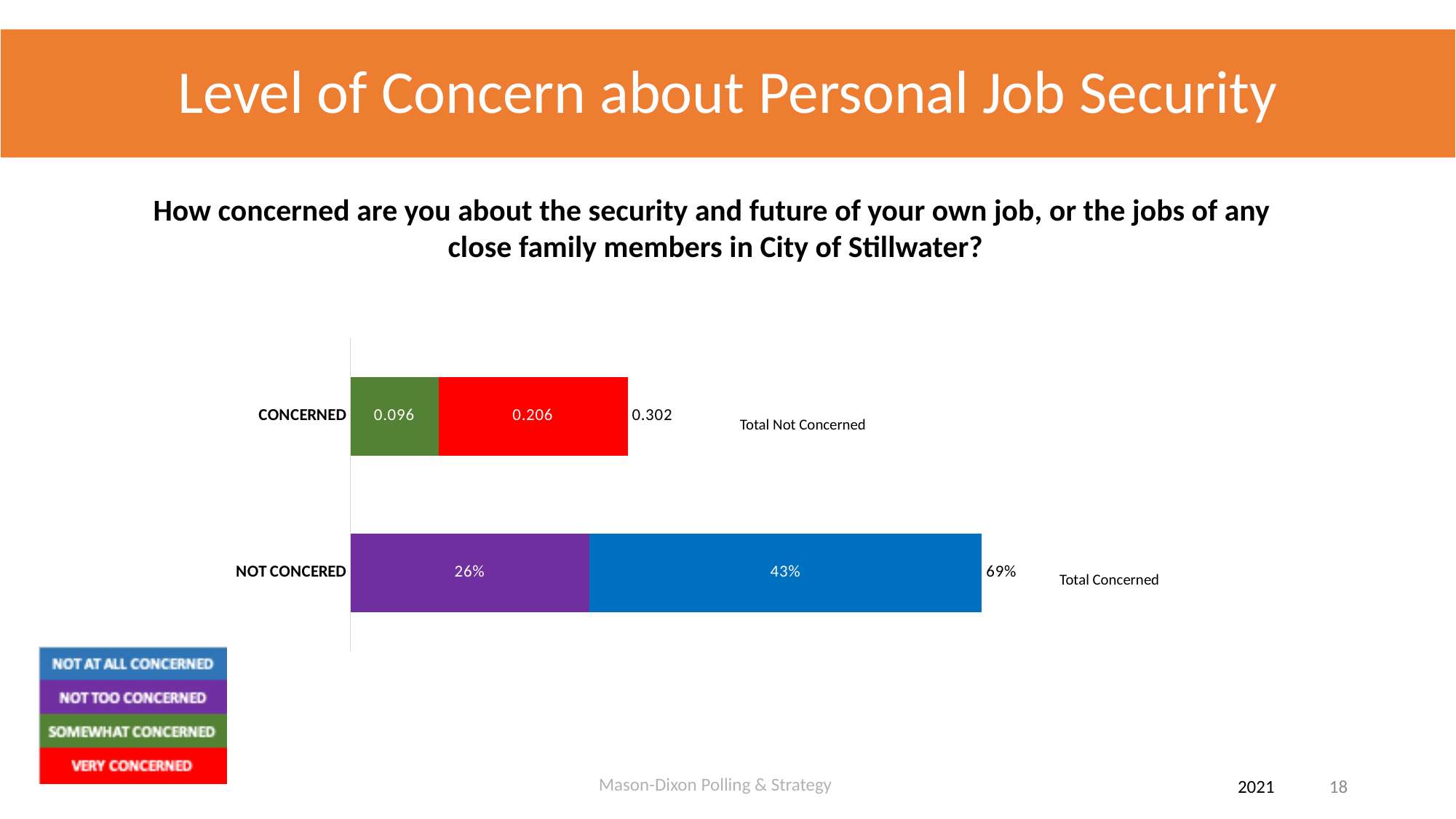
What is the difference between the Not At All Concerned segment (43%) and the Not Too Concerned segment (26%) in the NOT CONCERED bar? 17% Which bar is longer, CONCERNED or NOT CONCERED? NOT CONCERED What is the value of the green (Somewhat Concerned) segment in the CONCERNED bar? 0.096 How many category bars does the chart show? 2 What is the value of the purple (Not Too Concerned) segment in the NOT CONCERED bar? 26% What total is printed at the end of the CONCERNED bar? 0.302 What total is printed at the end of the NOT CONCERED bar? 69% Which legend entry is shown in red? VERY CONCERNED What type of chart is shown on the slide? Stacked bar chart What is the value of the blue (Not At All Concerned) segment in the NOT CONCERED bar? 43% How many entries does the legend list? 4 What is the value of the red (Very Concerned) segment in the CONCERNED bar? 0.206